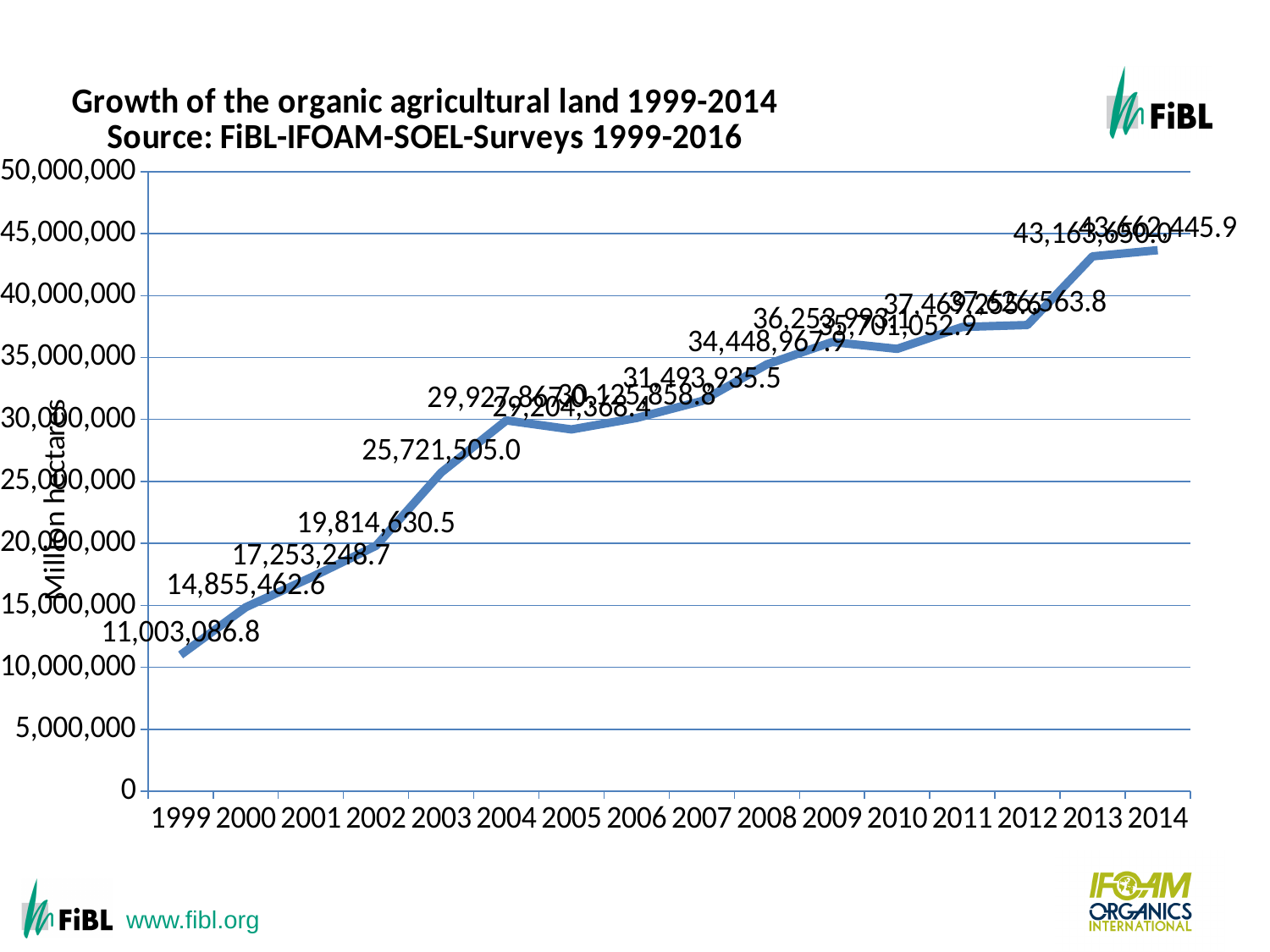
What is the difference between the values for 2000 and 1999? 3,852,375.8 Is the value for 2010 greater or less than 40,000,000? less How many years are plotted along the x axis? 16 What is the difference between the values for 2003 and 2002? 5,906,874.5 What is the value for 2007? 31,493,935.5 Which year has the highest value? 2014 Do the values generally rise or fall from 1999 to 2014? rise What is the value for 2008? 34,448,967.9 Which year has the lowest value? 1999 What kind of chart is shown on the slide? line chart What is the value for 2003? 25,721,505.0 What is the value for 1999? 11,003,086.8